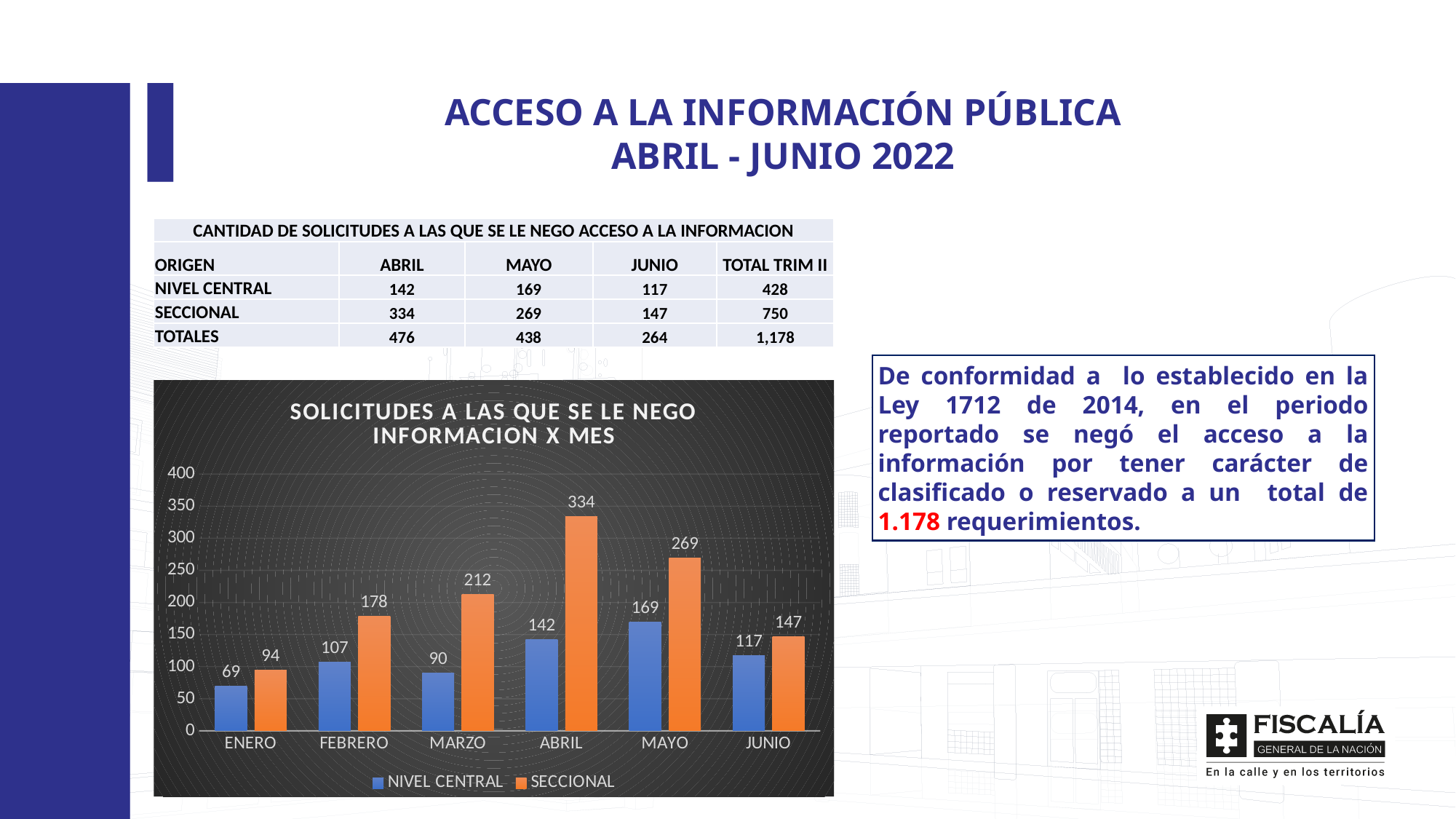
Do the NIVEL CENTRAL values rise or fall from ENERO to ABRIL? Rise What kind of chart is shown on the slide? Bar chart What is the SECCIONAL value for FEBRERO in the chart? 178 Which is larger in JUNIO, NIVEL CENTRAL or SECCIONAL? SECCIONAL What is the title of the chart? SOLICITUDES A LAS QUE SE LE NEGO INFORMACION X MES Which month has the lowest NIVEL CENTRAL value in the chart? ENERO Which month has the highest SECCIONAL value in the chart? ABRIL How many months are shown on the x axis of the chart? 6 What is the difference between the SECCIONAL and NIVEL CENTRAL values for MAYO? 100 Is the SECCIONAL value for MARZO greater or less than 200? greater How many series does the chart legend list? 2 What is the NIVEL CENTRAL value for ABRIL in the chart? 142